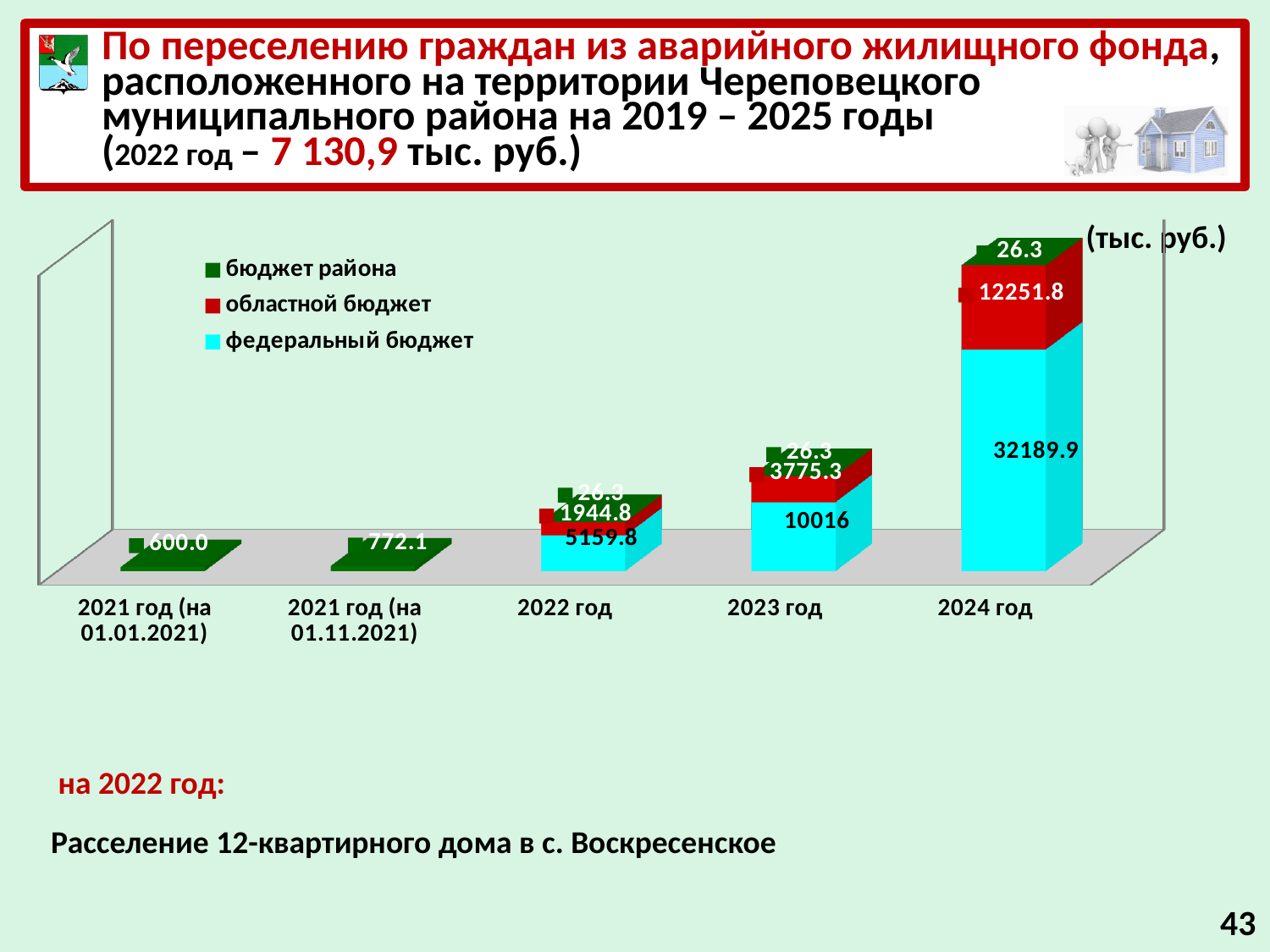
What is the total of the stacked bar for 2022 год? 7130.9 Which category has the highest total stacked value? 2024 год What is the value of федеральный бюджет for 2022 год? 5159.8 Which series is shown in red in the chart legend? областной бюджет What is the difference between the федеральный бюджет values for 2024 год and 2023 год? 22173.9 What is the value of федеральный бюджет for 2024 год? 32189.9 What type of chart is shown on the slide? stacked bar chart What is the value of бюджет района for 2021 год (на 01.11.2021)? 772.1 How many categories are shown on the x axis of the chart? 5 What is the value of областной бюджет for 2023 год? 3775.3 Which category has the lowest total stacked value? 2021 год (на 01.01.2021) How many series does the chart legend list? 3